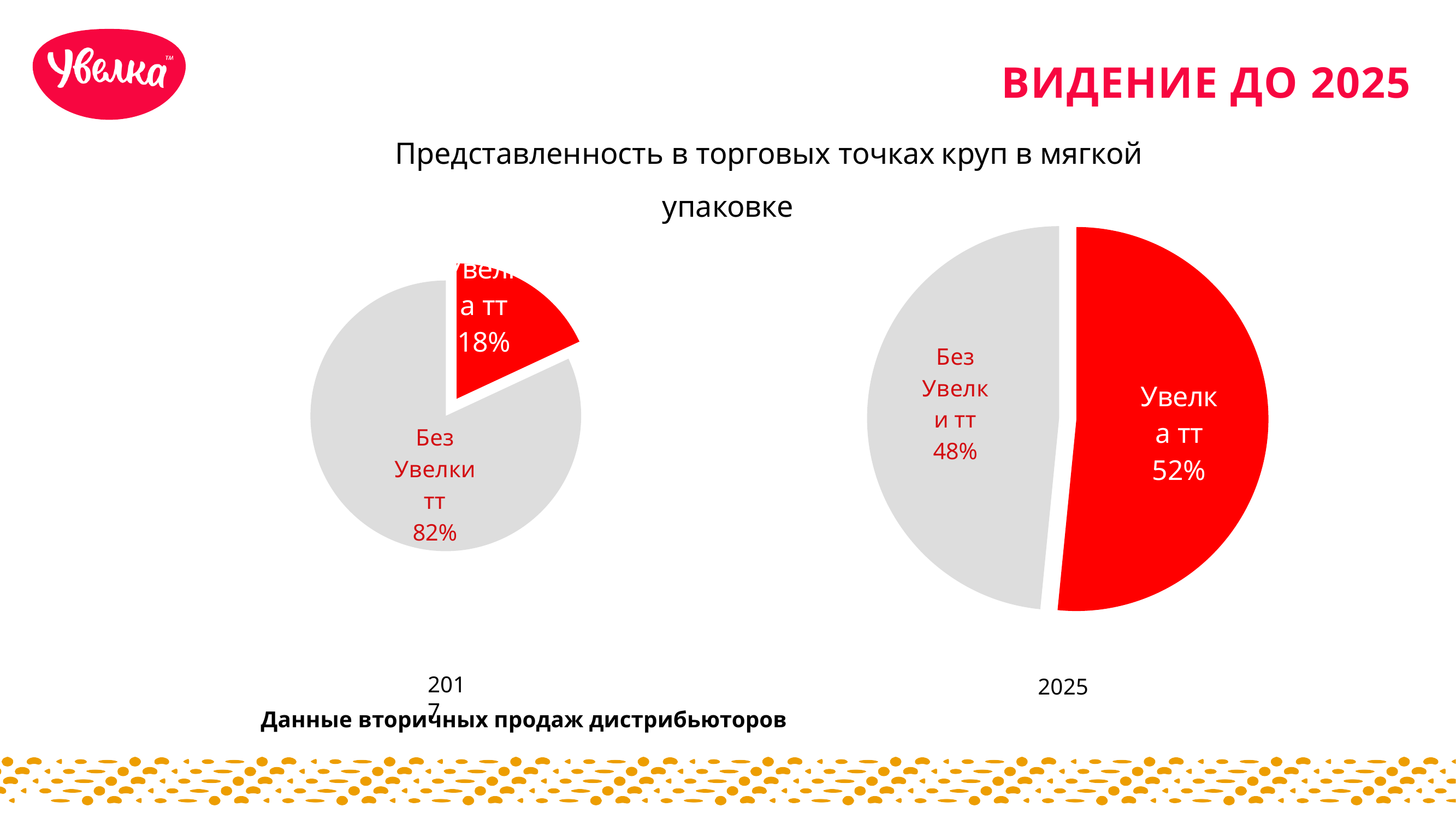
Which is larger: the "Увелка тт" share in the 2017 chart or the "Увелка тт" share in the 2025 chart? 2025 How many slices does the 2025 pie chart on the right have? 2 In the 2025 pie chart on the right, what share is labelled for "Без Увелки тт"? 48% What colour is the "Увелка тт" slice in both pie charts? Red In the 2017 pie chart on the left, what share is labelled for "Увелка тт"? 18% In the 2025 pie chart on the right, which slice is the smallest? Без Увелки тт What is the difference between the "Увелка тт" share in the 2025 chart and the "Увелка тт" share in the 2017 chart? 34 percentage points In the 2017 pie chart on the left, which slice is the largest? Без Увелки тт In the 2025 pie chart on the right, what share is labelled for "Увелка тт"? 52% What type of chart is used for the 2017 data on the left? Pie chart In the 2017 pie chart on the left, what share is labelled for "Без Увелки тт"? 82% In the 2017 pie chart on the left, what is the difference between the "Без Увелки тт" share and the "Увелка тт" share? 64 percentage points